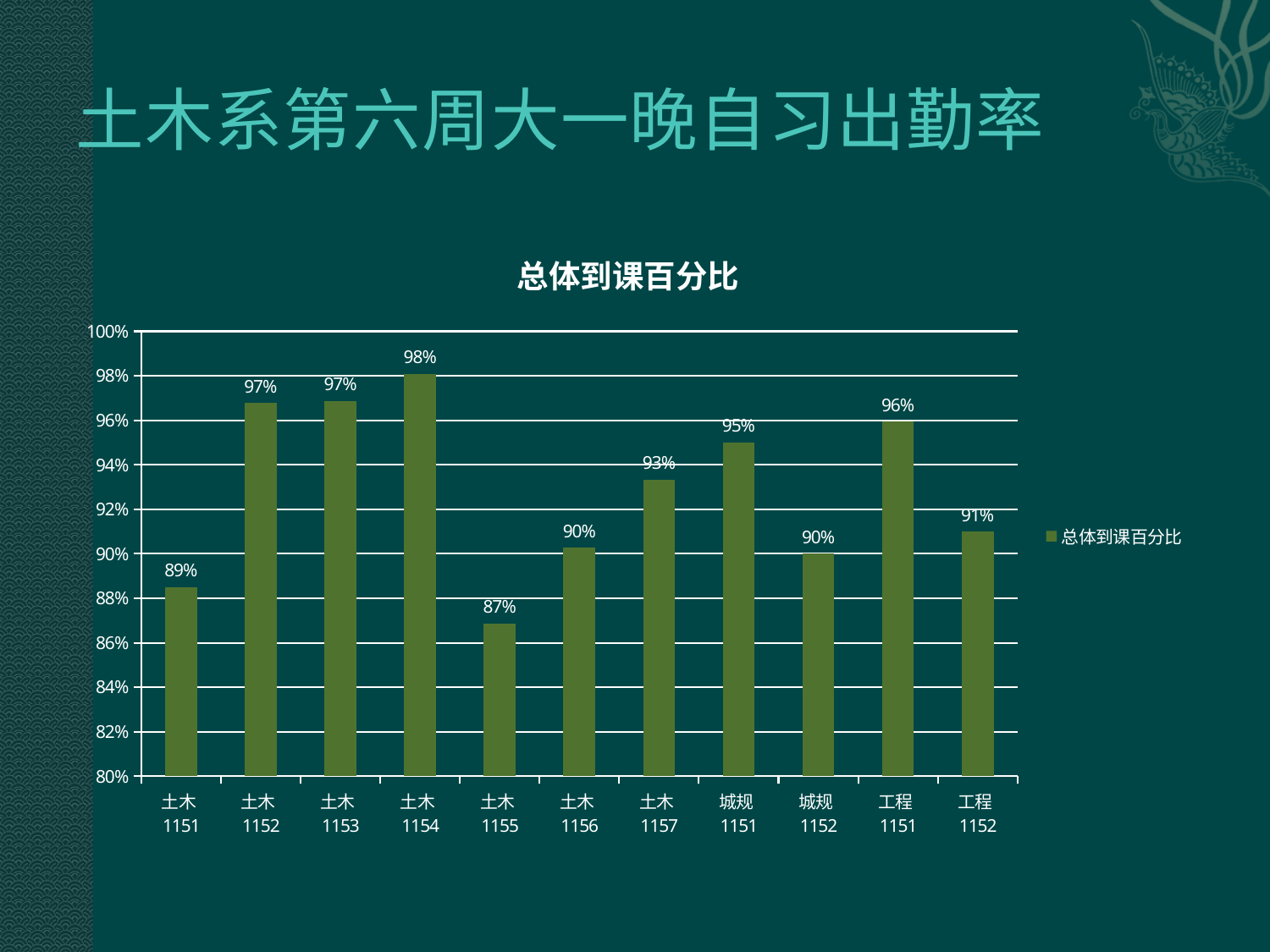
What is the difference between the attendance percentages of 土木1154 and 土木1155? 11% How many series does the legend list? 1 Which class has the highest attendance percentage? 土木1154 What kind of chart is shown on the slide? bar chart Is the value for 土木1151 greater or less than 90%? less What is the attendance percentage for 城规1151? 95% Which has a higher attendance percentage, 工程1151 or 工程1152? 工程1151 Which class has the lowest attendance percentage? 土木1155 What is the attendance percentage for 工程1152? 91% What is the title of the chart? 总体到课百分比 How many classes are shown on the x axis? 11 What is the attendance percentage for 土木1154? 98%